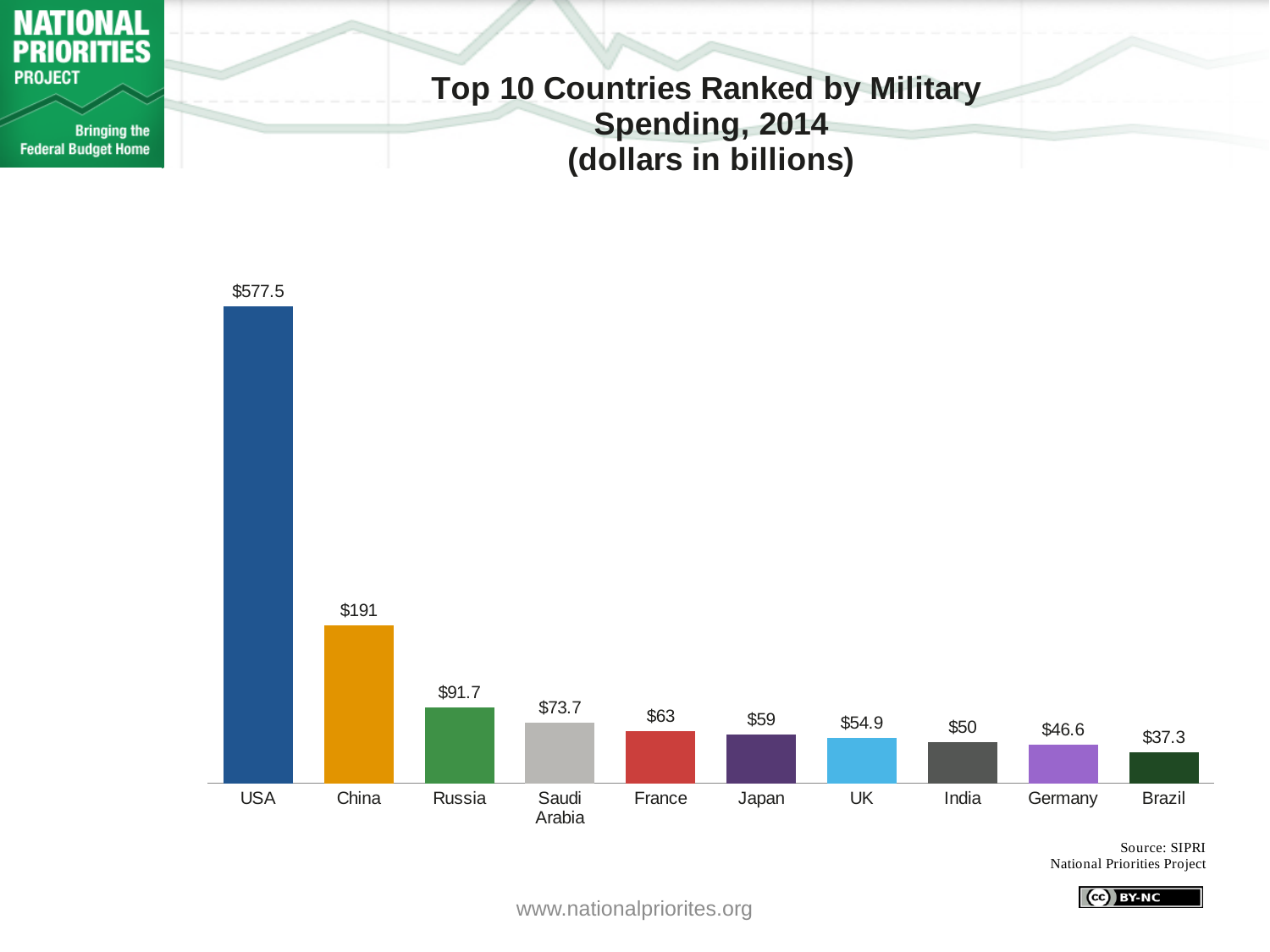
Which has a larger value, France or Japan? France What is the value shown for Saudi Arabia? $73.7 How many countries are shown in the chart? 10 What is the title of the chart? Top 10 Countries Ranked by Military Spending, 2014 (dollars in billions) What kind of chart is shown on the slide? Bar chart What is the difference between the values for Russia and Saudi Arabia? $18 What is the difference between the values for USA and China? $386.5 What is the military spending value shown for China? $191 What is the value shown for Germany? $46.6 Which country has the highest military spending in the chart? USA Do the values rise or fall moving from left to right across the chart? Fall Which country has the lowest military spending in the chart? Brazil